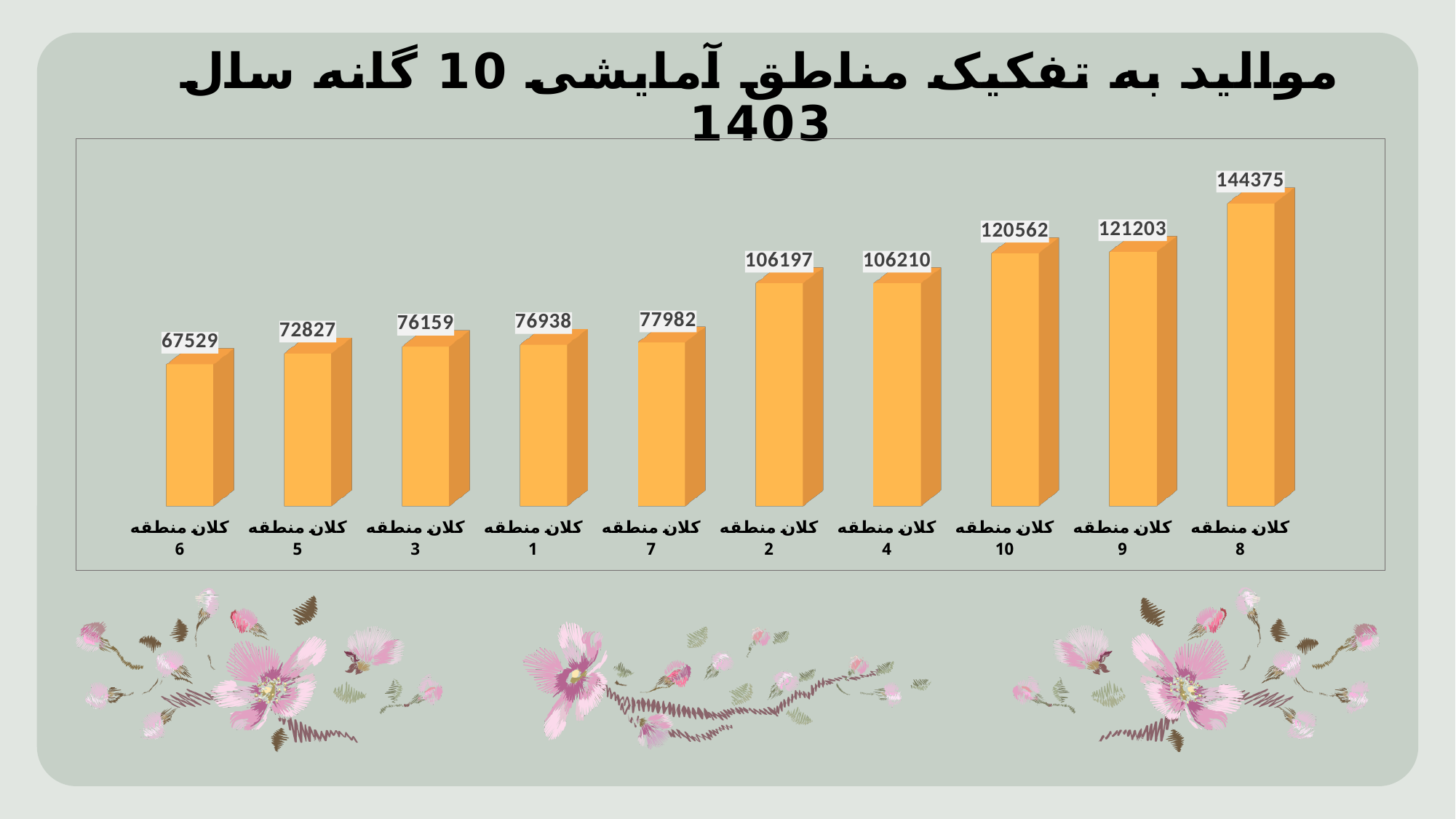
What is the value for کلان منطقه 8? 144375 What is the value for کلان منطقه 10? 120562 What is the difference between the values for کلان منطقه 8 and کلان منطقه 6? 76846 Which category has the lowest value? کلان منطقه 6 Do the values rise or fall from left to right along the x axis? Rise What is the value for کلان منطقه 2? 106197 Which is larger, the value for کلان منطقه 9 or the value for کلان منطقه 5? کلان منطقه 9 Which category has the highest value? کلان منطقه 8 How many categories are shown in the chart? 10 What is the difference between the values for کلان منطقه 9 and کلان منطقه 10? 641 What kind of chart is shown on the slide? Bar chart What is the value for کلان منطقه 6? 67529